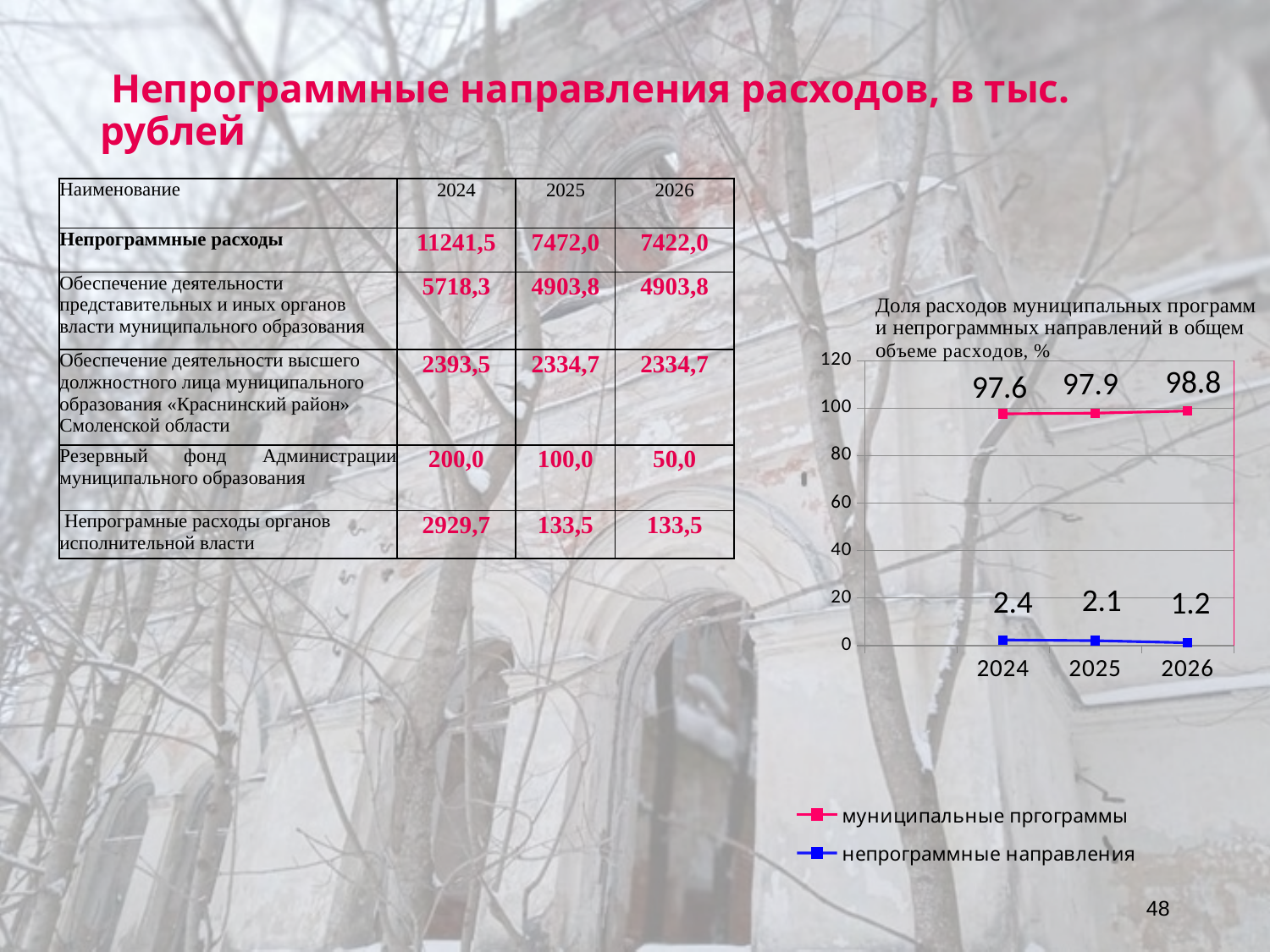
Which series is shown in blue in the chart legend? непрограммные направления Does the value for непрограммные направления rise or fall from 2024 to 2026? fall What is the difference between the муниципальные программы value in 2026 and in 2024? 1.2 What is the value for муниципальные программы in 2026? 98.8 What is the value for непрограммные направления in 2025? 2.1 In which year is the value for муниципальные программы the highest? 2026 How many years are plotted on the x axis of the chart? 3 How many series does the chart legend list? 2 In which year is the value for непрограммные направления the lowest? 2026 What type of chart is shown on the slide? line chart What is the value for непрограммные направления in 2026? 1.2 What is the value for муниципальные программы in 2024? 97.6